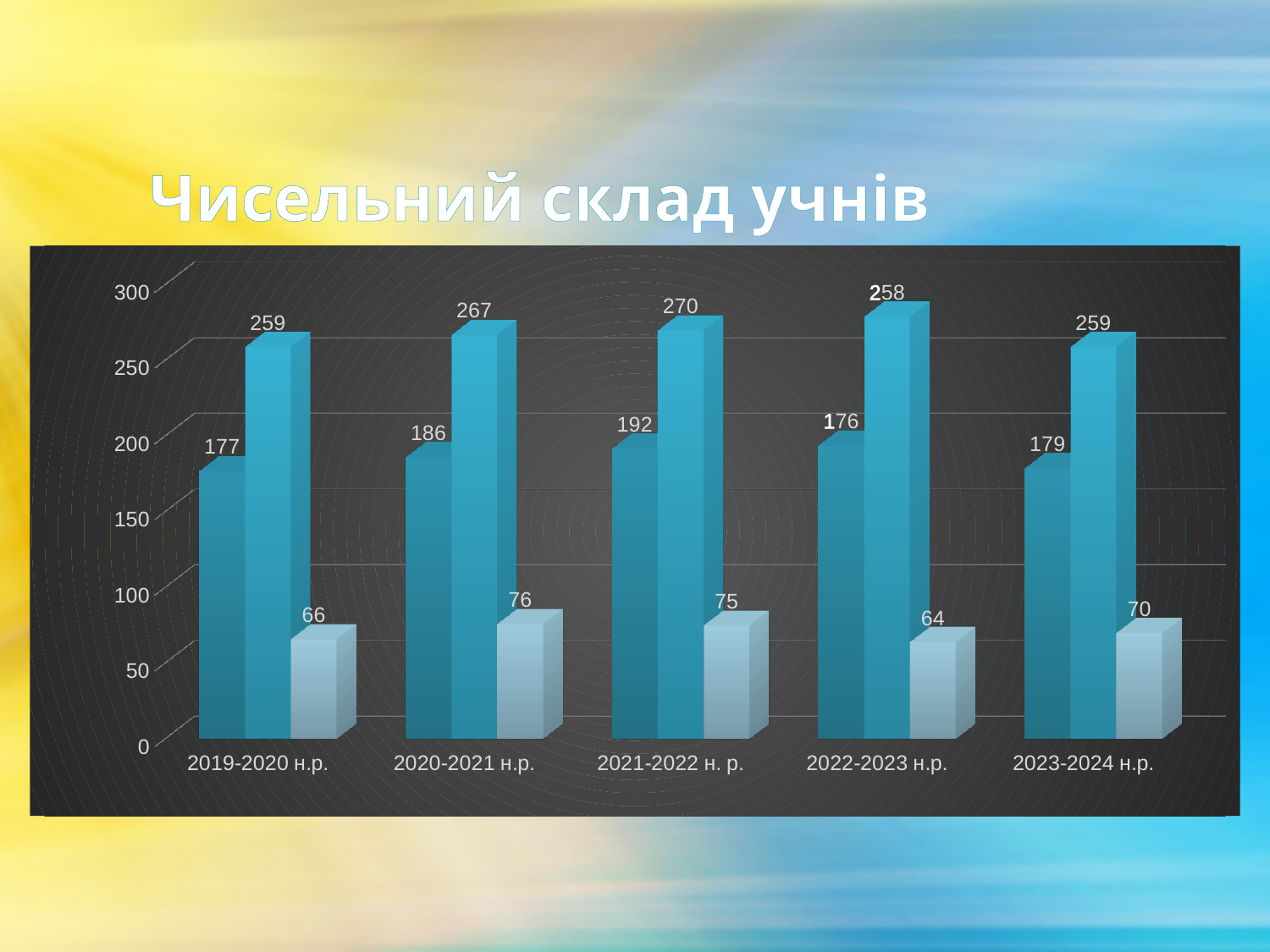
What is the title of the chart? Чисельний склад учнів What type of chart is shown on the slide? bar chart What is the difference between the smallest (right) bar values for 2020-2021 н.р. and 2023-2024 н.р.? 6 In which school year is the smallest (right, light) bar the lowest? 2022-2023 н.р. Which is larger: the first (left) bar for 2021-2022 н. р. or the first (left) bar for 2023-2024 н.р.? 2021-2022 н. р. What is the difference between the middle bar values for 2020-2021 н.р. and 2019-2020 н.р.? 8 What is the value of the smallest (right, light) bar for 2022-2023 н.р.? 64 How many categories (school years) are shown on the x axis? 5 What is the value of the tallest (middle) bar for 2021-2022 н. р.? 270 What is the value of the first (left) bar for 2020-2021 н.р.? 186 Is the value of the first (left) bar for 2019-2020 н.р. greater or less than 200? less